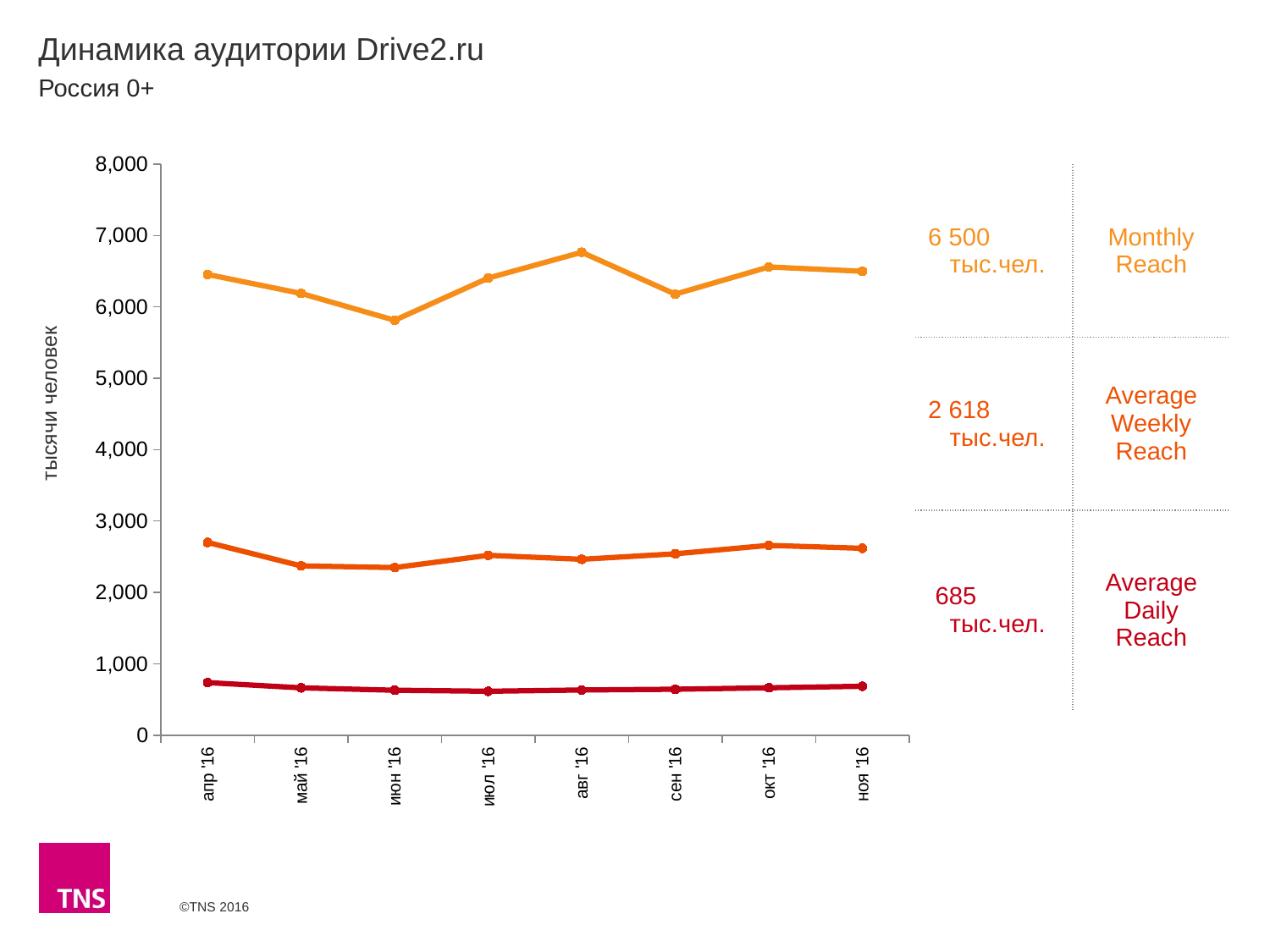
Is the Average Daily Reach value for апр '16 greater or less than 1,000? less Which month has the larger Monthly Reach, апр '16 or май '16? апр '16 Is the Average Weekly Reach value for апр '16 greater or less than 2,500? greater What is the label on the y axis of the chart? тысячи человек Is the Monthly Reach value for июн '16 greater or less than 6,000? less What type of chart is shown on the slide? line chart How many lines (series) are plotted on the chart? 3 In which month is Monthly Reach lowest? июн '16 In which month is Monthly Reach highest? авг '16 What Average Daily Reach value is printed in the panel to the right of the chart? 685 тыс.чел. How many months are plotted along the x axis? 8